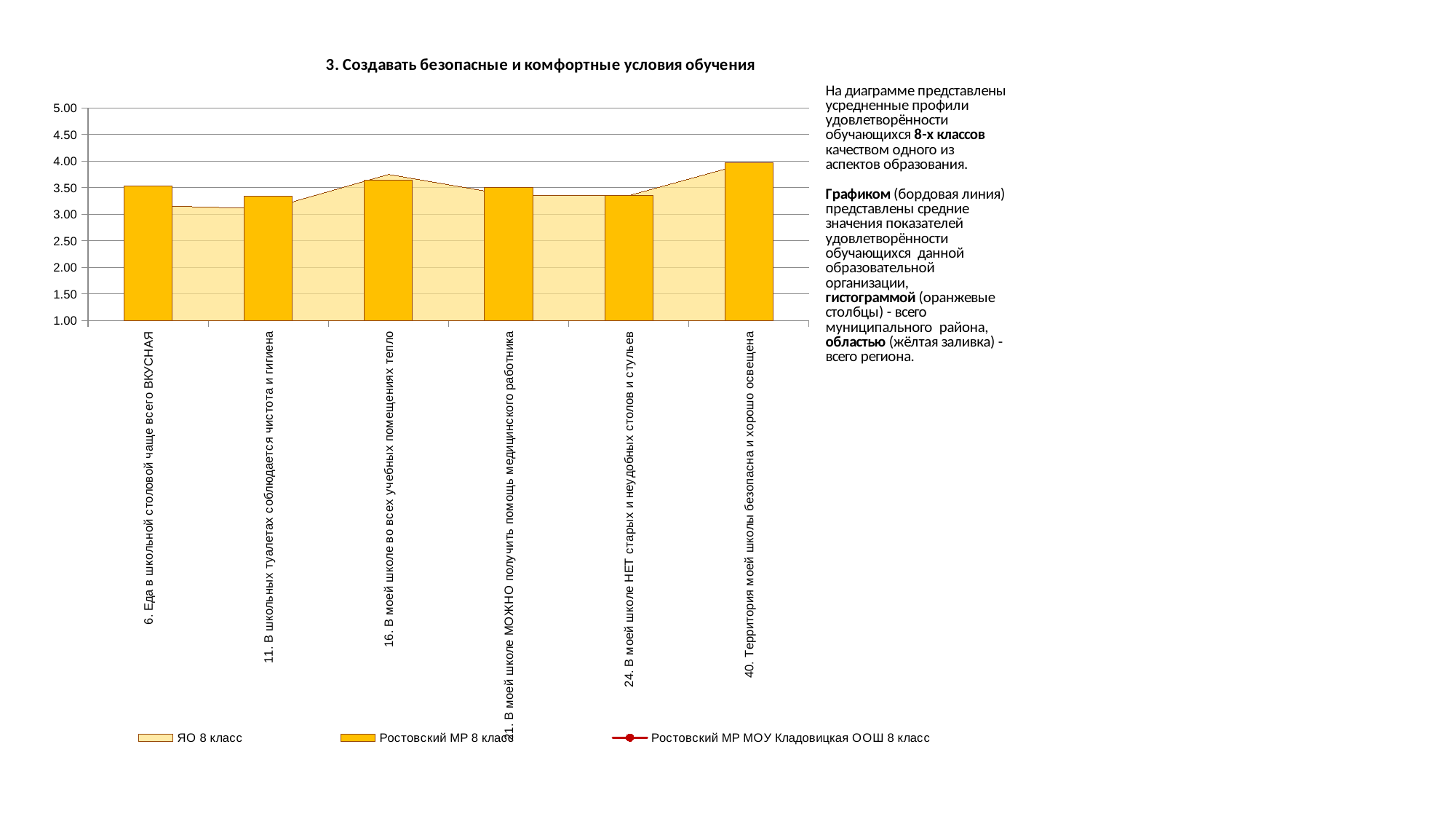
What kind of chart is used for the series 'Ростовский МР 8 класс'? bar chart Which series is shown by the orange bars according to the legend? Ростовский МР 8 класс Is the 'Ростовский МР 8 класс' bar for '11. В школьных туалетах соблюдается чистота и гигиена' greater or less than 3.50? less For the series 'Ростовский МР 8 класс', which bar is taller: '40. Территория моей школы безопасна и хорошо освещена' or '11. В школьных туалетах соблюдается чистота и гигиена'? 40. Территория моей школы безопасна и хорошо освещена For the series 'Ростовский МР 8 класс', which bar is taller: '6. Еда в школьной столовой чаще всего ВКУСНАЯ' or '11. В школьных туалетах соблюдается чистота и гигиена'? 6. Еда в школьной столовой чаще всего ВКУСНАЯ For the series 'Ростовский МР 8 класс', which category has the highest bar? 40. Территория моей школы безопасна и хорошо освещена How many series does the chart legend list? 3 Is the 'Ростовский МР 8 класс' bar for '24. В моей школе НЕТ старых и неудобных столов и стульев' greater or less than 4.00? less Is the 'Ростовский МР 8 класс' bar for '40. Территория моей школы безопасна и хорошо освещена' greater or less than 3.50? greater How many categories are shown on the x axis of the chart? 6 What is the title of the chart? 3. Создавать безопасные и комфортные условия обучения